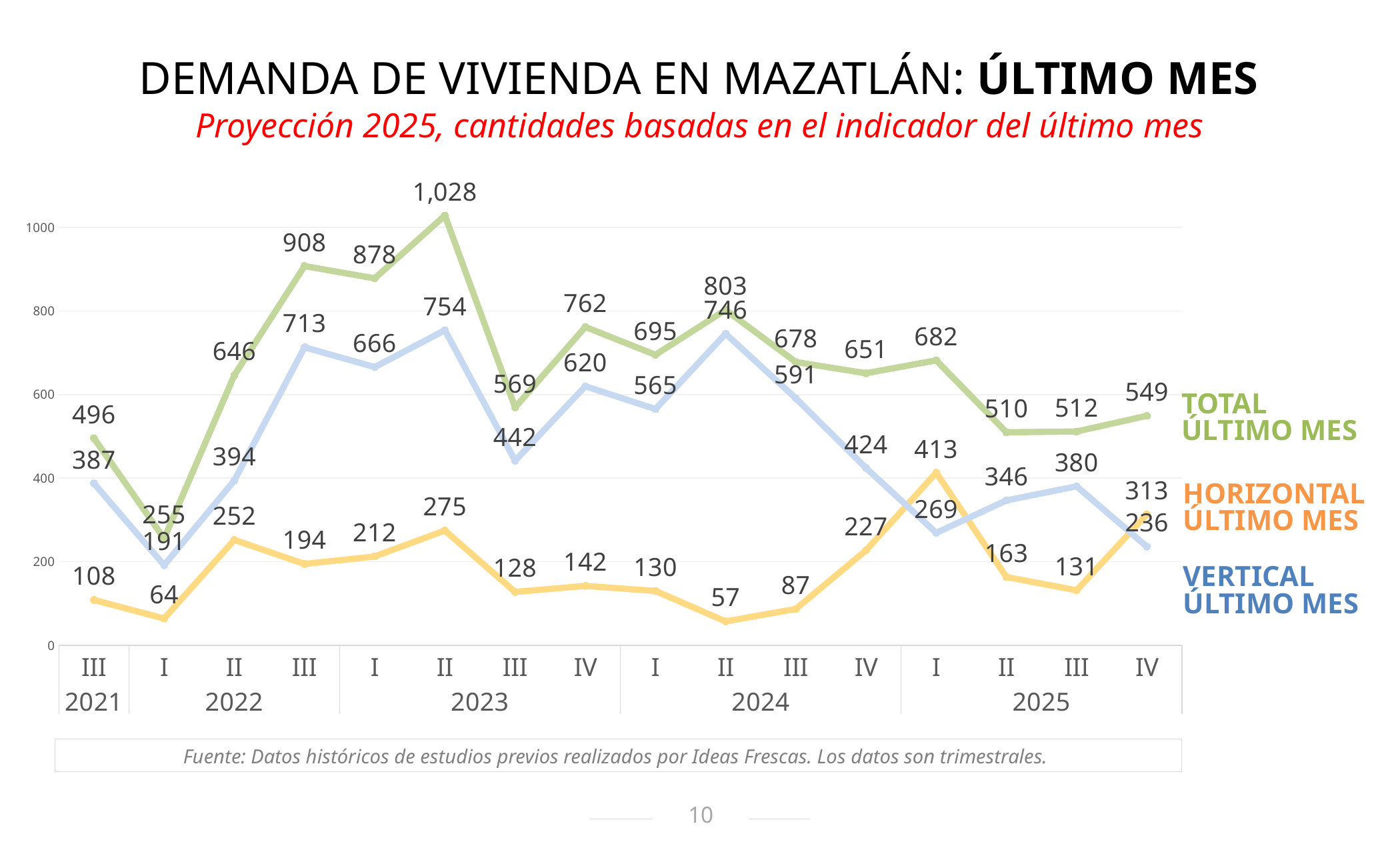
Does TOTAL ÚLTIMO MES rise or fall from quarter I of 2025 to quarter II of 2025? Fall In which quarter does HORIZONTAL ÚLTIMO MES reach its lowest value? II 2024 What is the difference between TOTAL ÚLTIMO MES and VERTICAL ÚLTIMO MES in quarter IV of 2025? 313 How many quarters are plotted on the x axis? 16 What is the value of HORIZONTAL ÚLTIMO MES in quarter I of 2025? 413 What is the value of TOTAL ÚLTIMO MES in quarter II of 2023? 1,028 Is the value of VERTICAL ÚLTIMO MES in quarter II of 2024 greater or less than 600? greater In which quarter does TOTAL ÚLTIMO MES reach its highest value? II 2023 How many series does the chart show? 3 What kind of chart is shown on the slide? Line chart Which is larger in quarter I of 2025: HORIZONTAL ÚLTIMO MES or VERTICAL ÚLTIMO MES? HORIZONTAL ÚLTIMO MES What is the value of VERTICAL ÚLTIMO MES in quarter III of 2022? 713